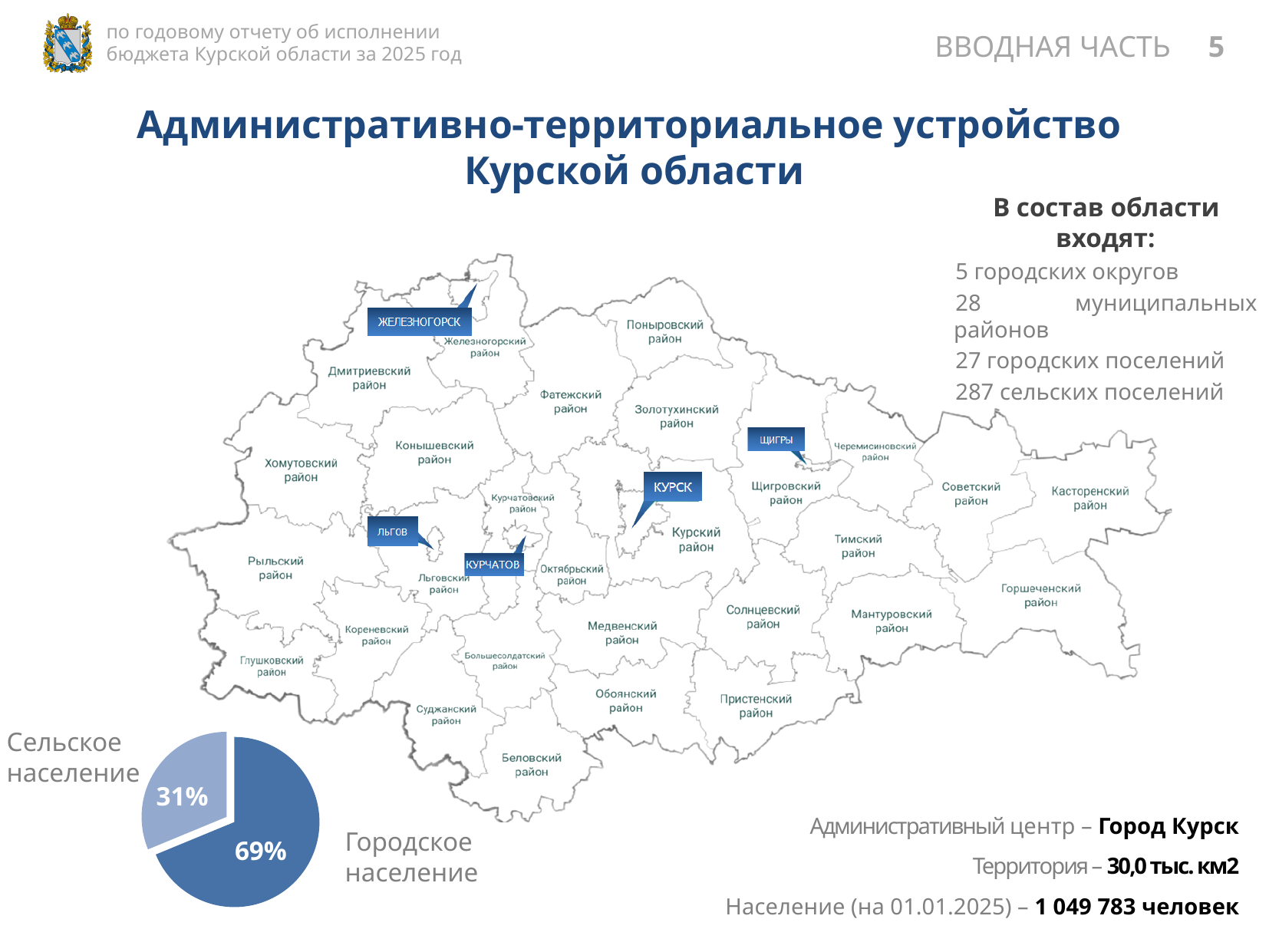
How many slices does the pie chart have? 2 Which slice of the pie chart is the largest? Городское население What is the difference in percentage points between Городское население and Сельское население in the pie chart? 38 Which is larger in the pie chart: Сельское население or Городское население? Городское население What share of the pie chart is Городское население? 69% Is the share for Сельское население in the pie chart greater or less than 50%? less What share of the pie chart is Сельское население? 31% Which slice of the pie chart is drawn in the darker blue colour? Городское население What is the total of the two slices shown in the pie chart? 100% Is the share for Городское население in the pie chart greater or less than 50%? greater What kind of chart is shown in the bottom-left of the slide? Pie chart Which slice of the pie chart is the smallest? Сельское население